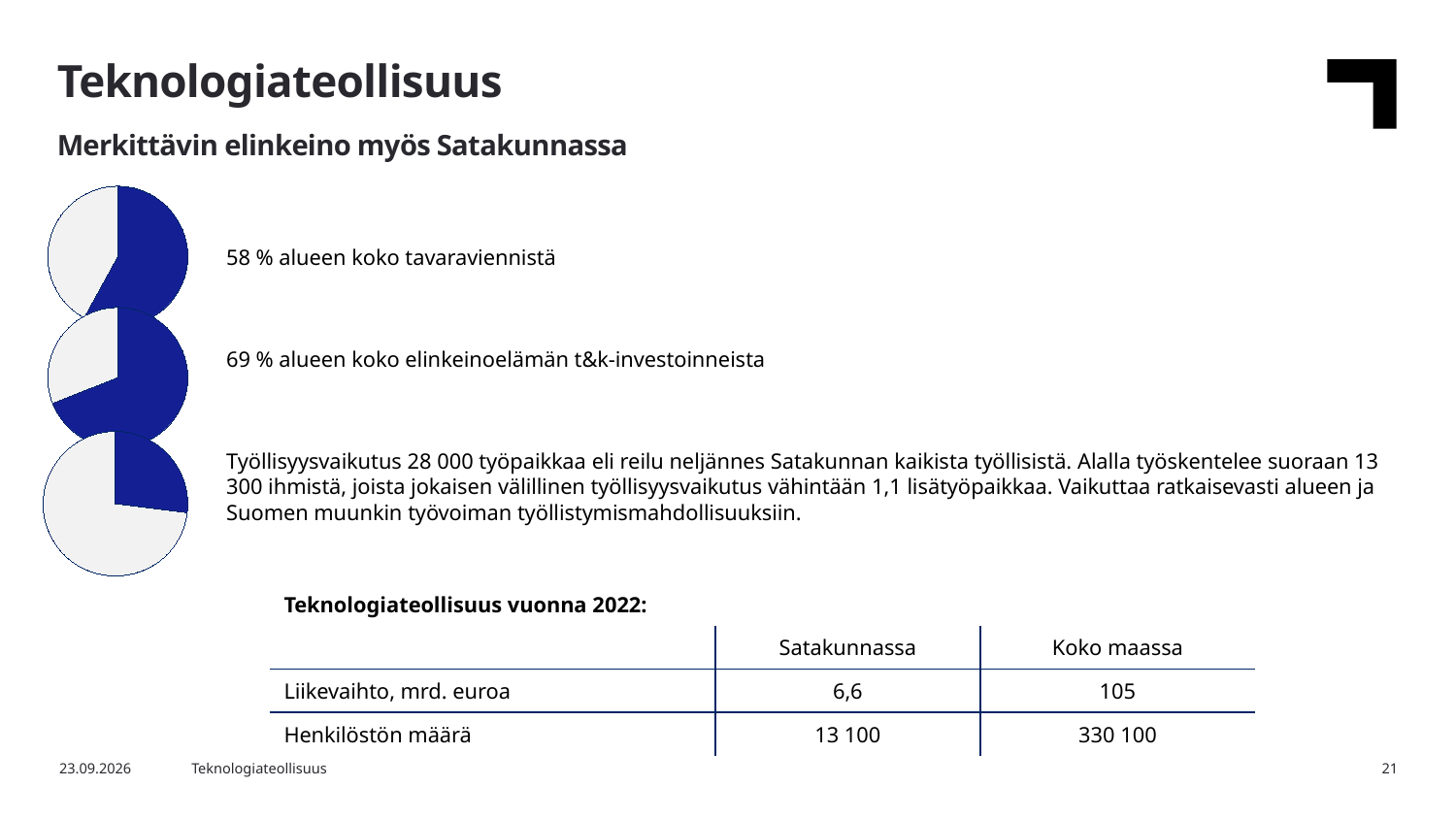
Which of the three pie charts has the largest dark blue slice? The middle pie chart Is the dark blue slice in the middle pie chart greater or less than 50% of the pie? greater How many slices does each pie chart have? 2 What is the difference in percentage points between the shares shown for the middle pie chart (69 %) and the top pie chart (58 %)? 11 percentage points Which of the three pie charts has the smallest dark blue slice? The bottom pie chart Is the dark blue slice in the bottom pie chart greater or less than 50% of the pie? less What kind of charts are shown on the left side of the slide? Pie charts What share of the region's total goods exports does the top pie chart represent, according to the text next to it? 58 % How many pie charts are on the slide? 3 What colour is the highlighted slice in each pie chart? Dark blue Is the dark blue slice in the top pie chart larger or smaller than the dark blue slice in the middle pie chart? smaller What share of the region's business R&D investments does the middle pie chart represent, according to the text next to it? 69 %